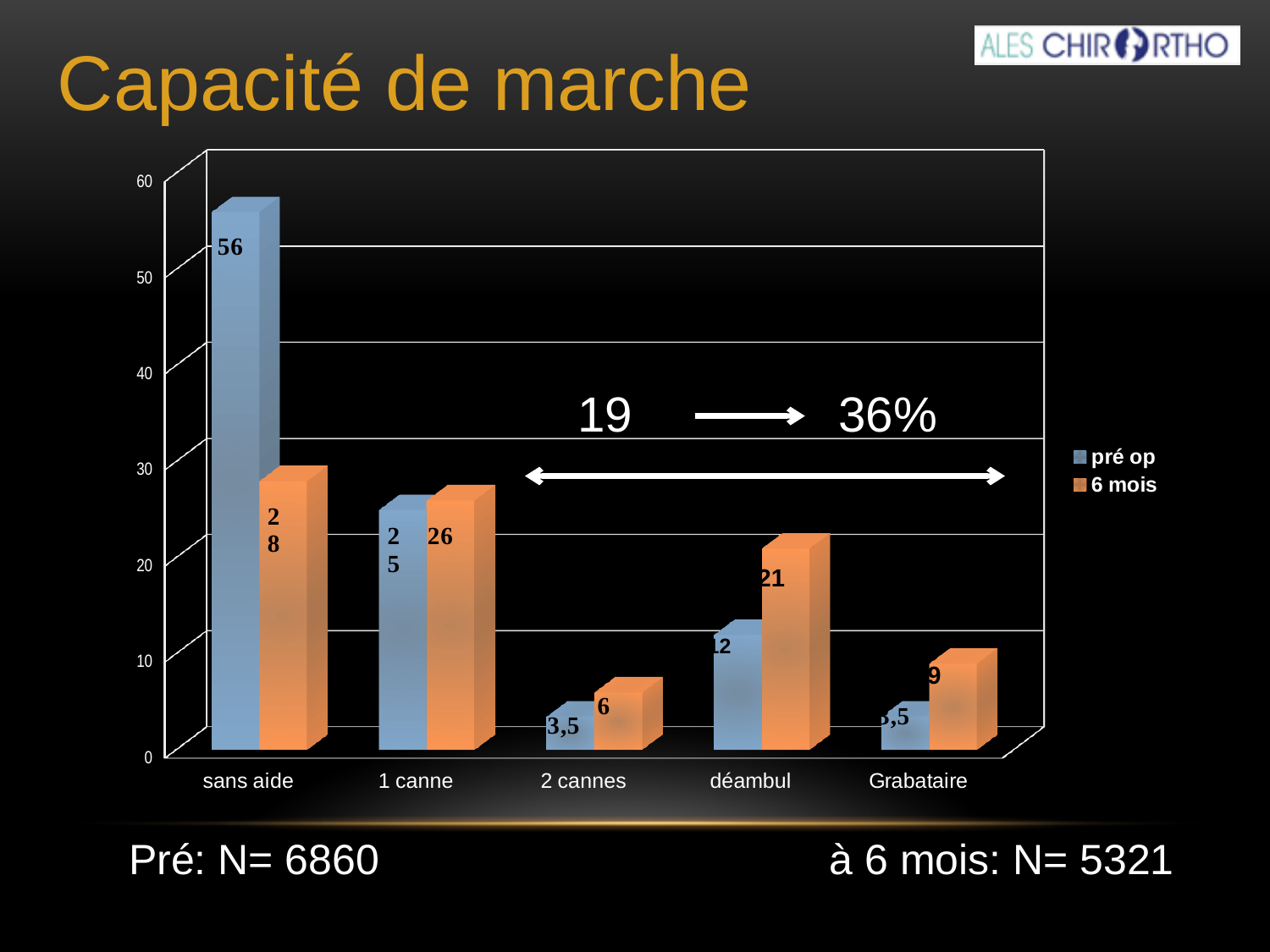
How many series does the legend list? 2 What is the difference between the pré op and 6 mois values for sans aide? 28 How many categories are shown on the x axis? 5 Which category has the highest pré op value? sans aide What is the 6 mois value for sans aide? 28 What kind of chart is shown on the slide? bar chart What is the pré op value for sans aide? 56 What is the 6 mois value for déambul? 21 What is the pré op value for 2 cannes? 3,5 For déambul, which is larger: the pré op value or the 6 mois value? 6 mois Which category has the lowest 6 mois value? 2 cannes Is the pré op value for déambul greater or less than 10? greater